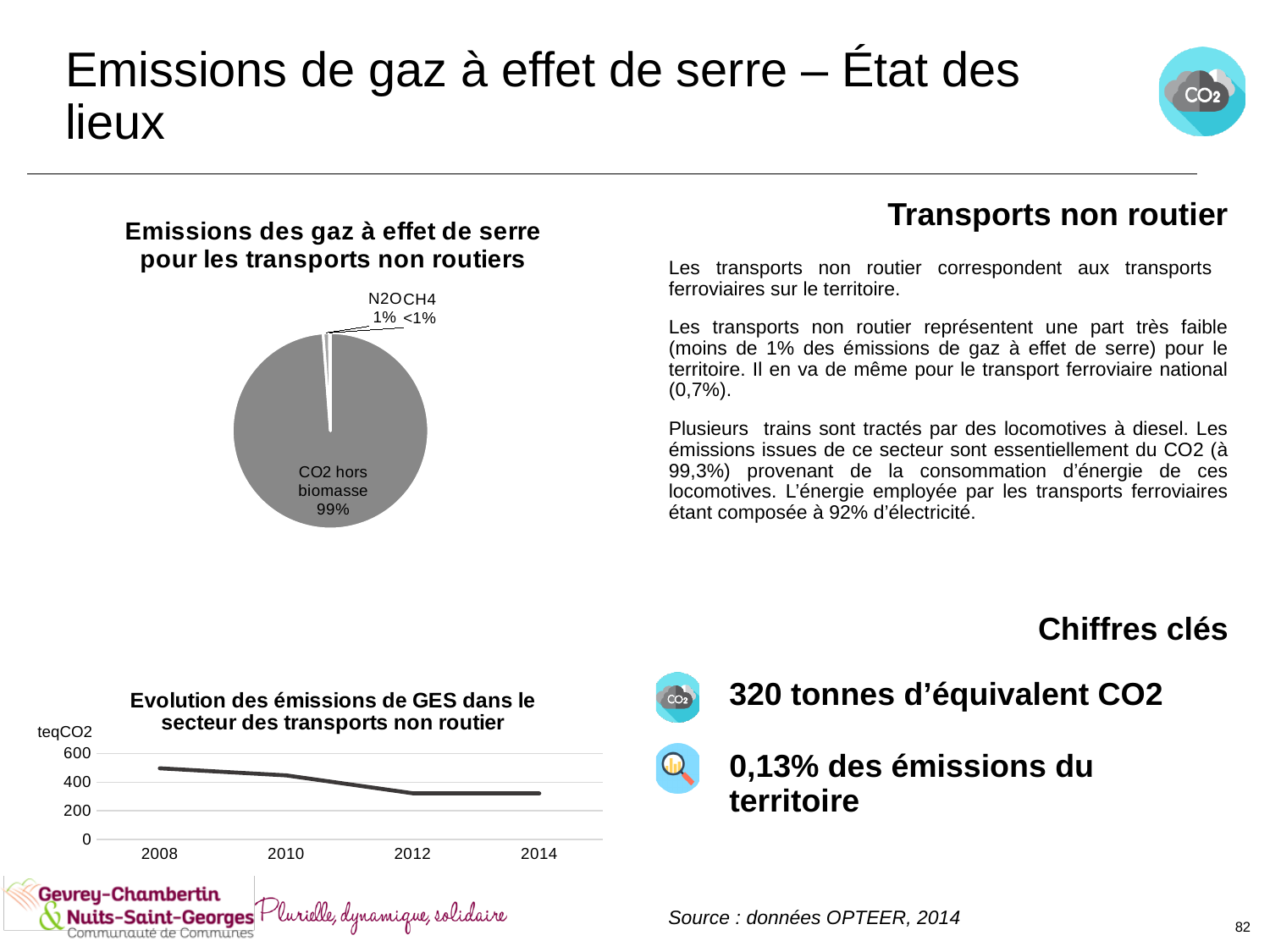
In the pie chart 'Emissions des gaz à effet de serre pour les transports non routiers', what share is labelled for CO2 hors biomasse? 99% In the pie chart 'Emissions des gaz à effet de serre pour les transports non routiers', how many slices are labelled? 3 In the chart 'Evolution des émissions de GES dans le secteur des transports non routier', is the value for 2008 greater or less than 400? greater What kind of chart is 'Evolution des émissions de GES dans le secteur des transports non routier'? Line chart In the chart 'Evolution des émissions de GES dans le secteur des transports non routier', do emissions rise or fall from 2008 to 2014? Fall In the chart 'Evolution des émissions de GES dans le secteur des transports non routier', how many years are shown on the x axis? 4 In the chart 'Evolution des émissions de GES dans le secteur des transports non routier', is the value for 2014 greater or less than 400? less What kind of chart is 'Emissions des gaz à effet de serre pour les transports non routiers'? Pie chart In the pie chart 'Emissions des gaz à effet de serre pour les transports non routiers', which gas has the largest slice? CO2 hors biomasse In the pie chart 'Emissions des gaz à effet de serre pour les transports non routiers', what share is labelled for N2O? 1% In the pie chart 'Emissions des gaz à effet de serre pour les transports non routiers', what share is labelled for CH4? <1% In the chart 'Evolution des émissions de GES dans le secteur des transports non routier', what unit is shown on the y axis? teqCO2